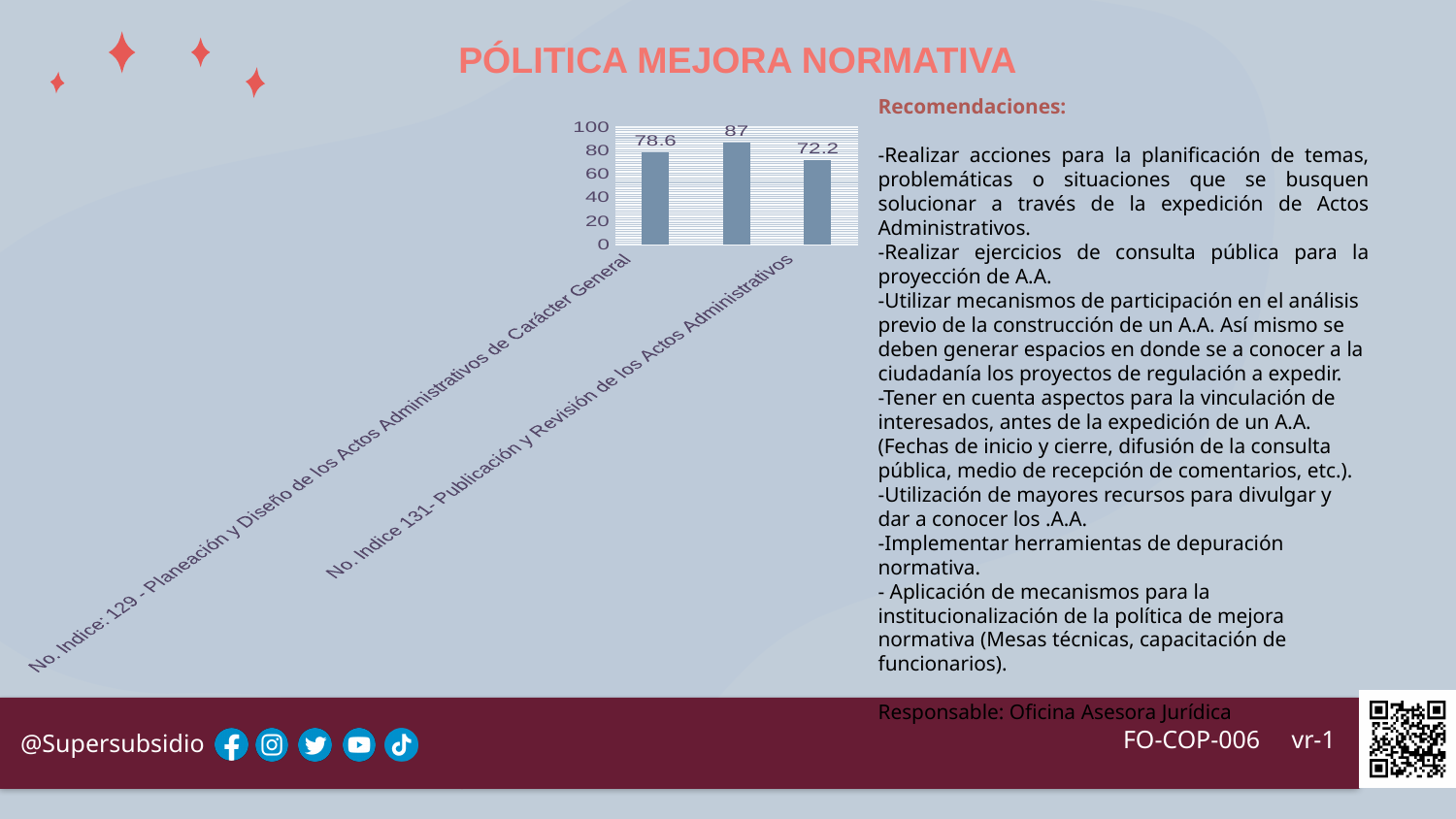
Which is larger: the value for 'No. Indice: 129 - Planeación y Diseño de los Actos Administrativos de Carácter General' or the value of the rightmost bar? No. Indice: 129 - Planeación y Diseño de los Actos Administrativos de Carácter General What is the difference between the highest and lowest bar values? 14.8 What is the value for 'No. Indice: 129 - Planeación y Diseño de los Actos Administrativos de Carácter General'? 78.6 What is the maximum value shown on the vertical axis of the chart? 100 What type of chart is shown on the slide? bar chart Is the value for 'No. Indice 131- Publicación y Revisión de los Actos Administrativos' greater or less than 80? less What is the value of the third (rightmost) bar in the chart? 72.2 What is the value of the lowest bar in the chart? 72.2 What is the difference between the value for 'No. Indice 131- Publicación y Revisión de los Actos Administrativos' and the value for 'No. Indice: 129 - Planeación y Diseño de los Actos Administrativos de Carácter General'? 6.4 How many bars are plotted in the chart? 3 What is the value for 'No. Indice 131- Publicación y Revisión de los Actos Administrativos'? 72.2